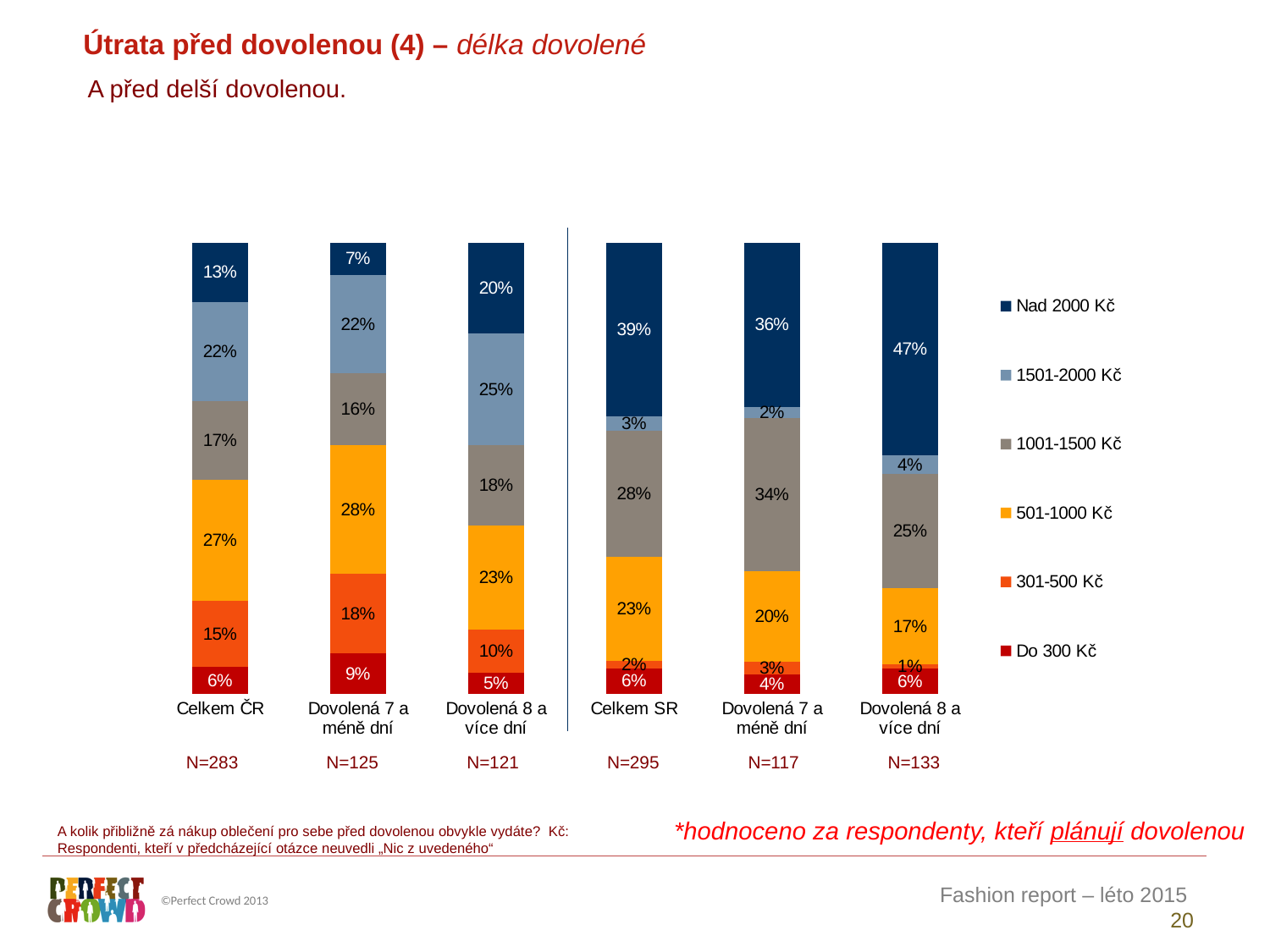
Which bar has the lowest 'Nad 2000 Kč' value? Dovolená 7 a méně dní (ČR) What is the value of the '501-1000 Kč' segment for 'Celkem SR'? 23% Which is larger: the '1001-1500 Kč' value for 'Celkem ČR' or for 'Celkem SR'? Celkem SR What is the sample size (N) shown under the 'Celkem SR' bar? N=295 What is the value of the '301-500 Kč' segment for the 'Dovolená 7 a méně dní' bar on the ČR (left) side of the chart? 18% What is the value of the 'Nad 2000 Kč' segment for 'Celkem ČR'? 13% What kind of chart is shown on the slide? Stacked bar chart How many series does the legend list? 6 What is the difference between the 'Nad 2000 Kč' values for 'Celkem SR' and 'Celkem ČR'? 26 percentage points Which bar has the highest 'Nad 2000 Kč' value? Dovolená 8 a více dní (SR) How many bars (categories) are plotted in the chart? 6 What is the value of the 'Nad 2000 Kč' segment for the 'Dovolená 8 a více dní' bar on the SR (right) side of the chart? 47%